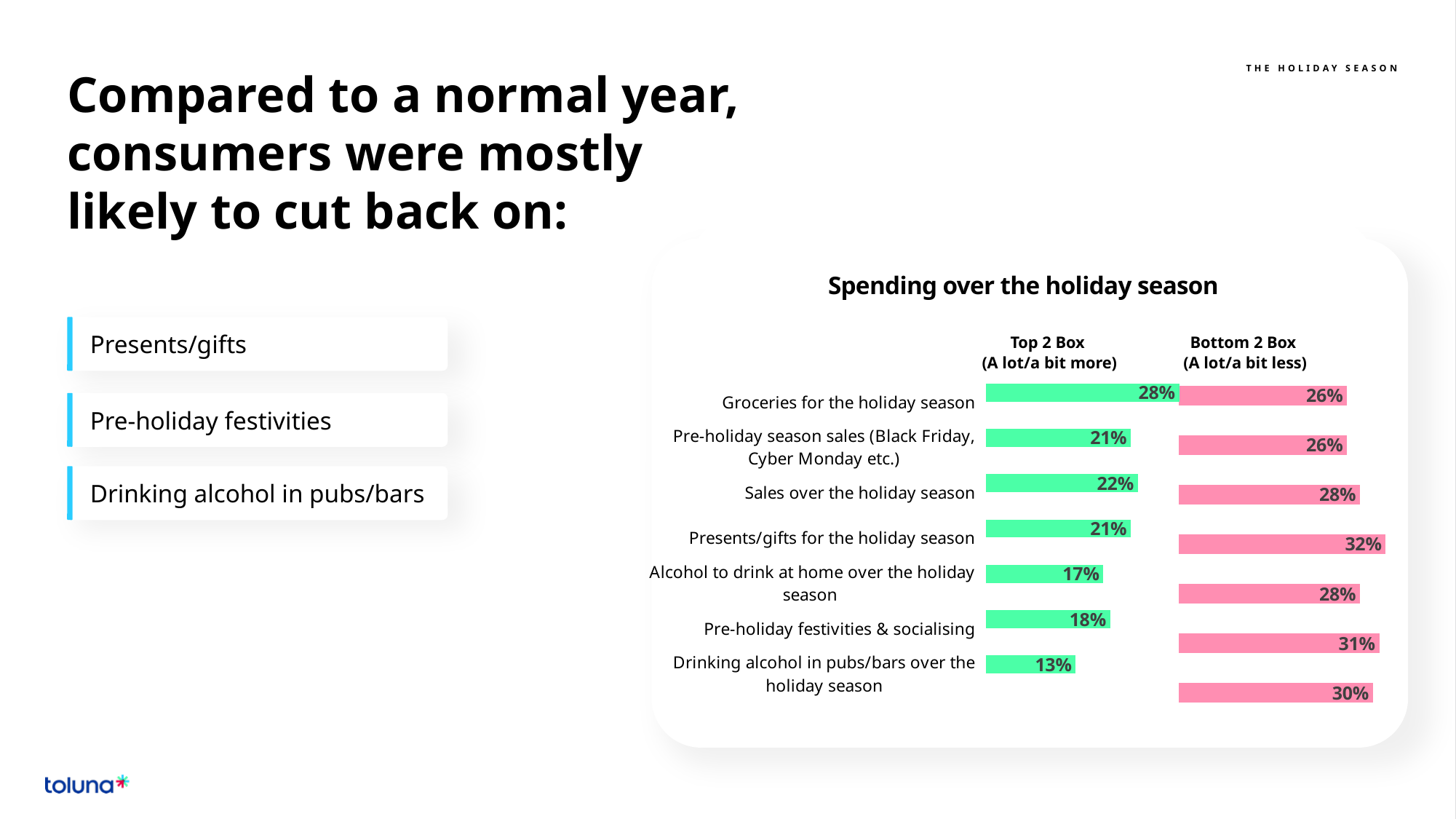
What is the title of the chart on the slide? Spending over the holiday season How many series does the chart show? 2 What is the Top 2 Box value for Drinking alcohol in pubs/bars over the holiday season? 13% What type of chart is used for Spending over the holiday season? Bar chart For Groceries for the holiday season, which is larger: the Top 2 Box value or the Bottom 2 Box value? Top 2 Box Which category has the highest Bottom 2 Box (A lot/a bit less) value? Presents/gifts for the holiday season What is the Bottom 2 Box (A lot/a bit less) value for Presents/gifts for the holiday season? 32% Which category has the highest Top 2 Box (A lot/a bit more) value? Groceries for the holiday season What is the Top 2 Box (A lot/a bit more) value for Groceries for the holiday season? 28% Which category has the lowest Top 2 Box (A lot/a bit more) value? Drinking alcohol in pubs/bars over the holiday season What is the difference between the Bottom 2 Box and Top 2 Box values for Drinking alcohol in pubs/bars over the holiday season? 17% How many spending categories are shown in the chart? 7